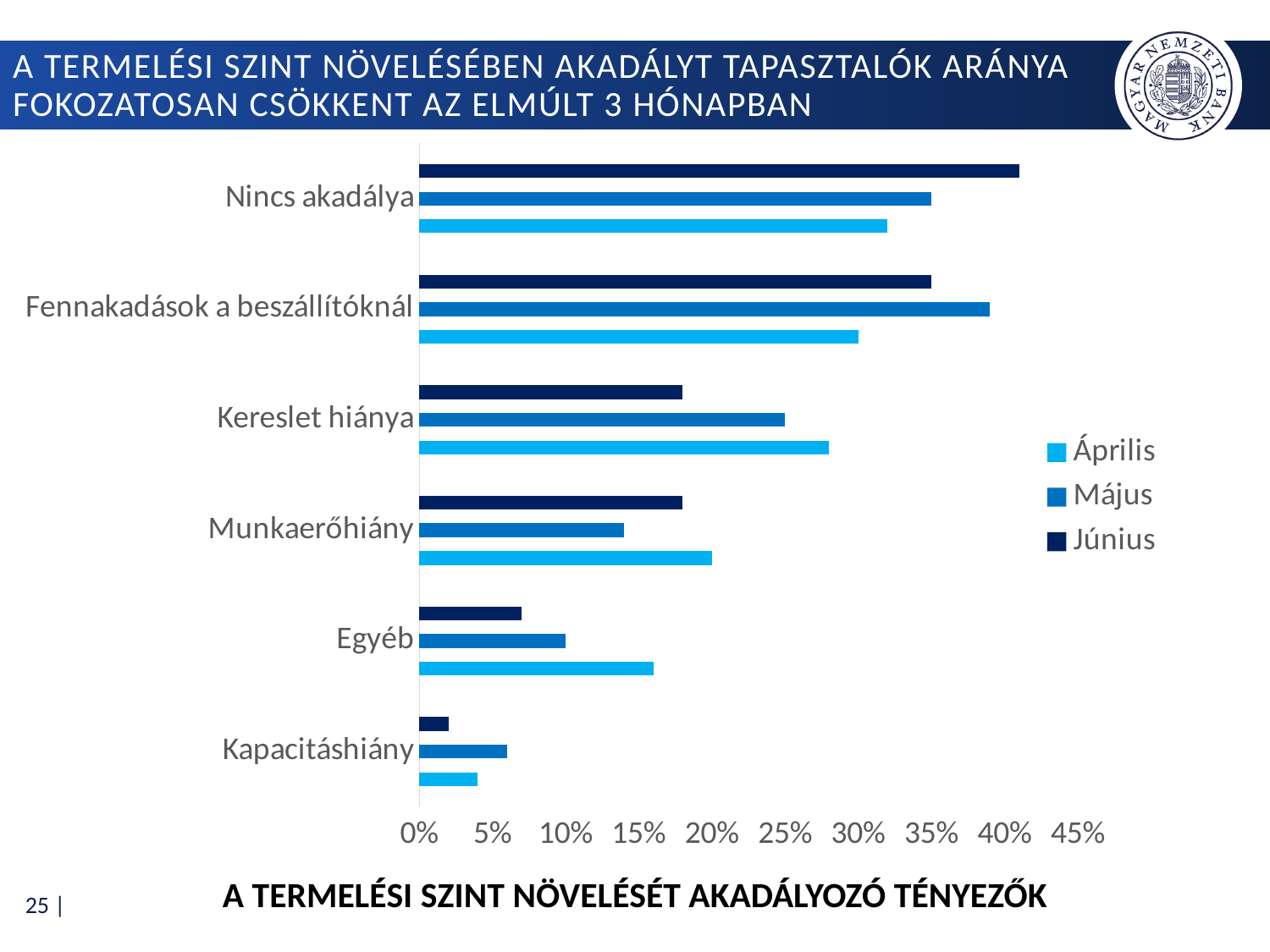
How many categories are shown on the chart? 6 Which category has the highest value for Május? Fennakadások a beszállítóknál Is the value for Kapacitáshiány in Június greater or less than 5%? less Is the value for Nincs akadálya in Június greater or less than 35%? greater Is the value for Egyéb in Április greater or less than 10%? greater What kind of chart is shown on the slide? bar chart What are the three legend entries of the chart? Április, Május, Június How many series does the legend list? 3 For Kereslet hiánya, which is larger: the Április value or the Június value? Április Which category has the highest value for Június? Nincs akadálya For Egyéb, do the values rise or fall from Április to Június? fall Which category has the lowest value for Június? Kapacitáshiány